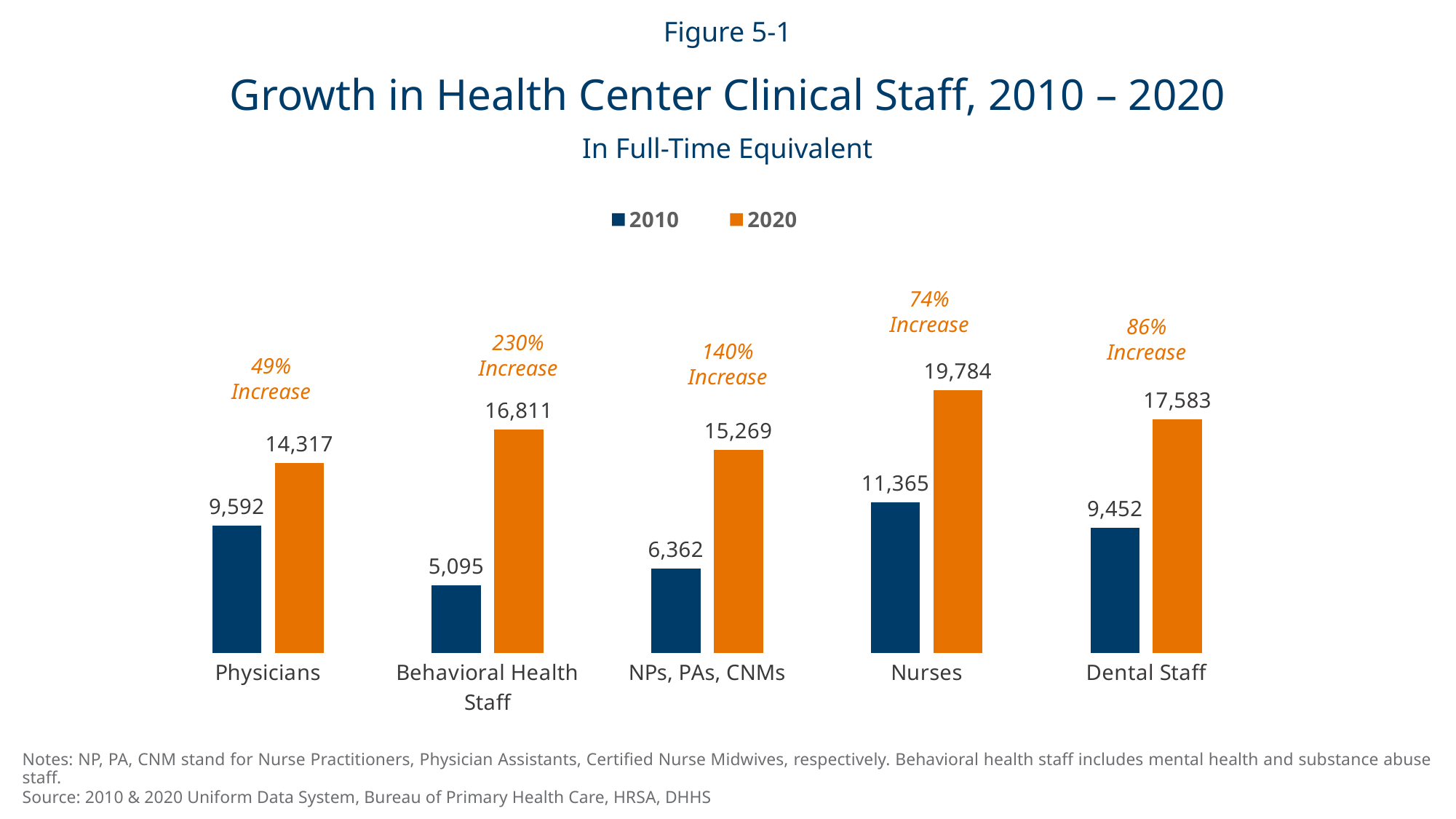
Which category had the highest value in 2020? Nurses What is the difference between the 2020 and 2010 values for Dental Staff? 8,131 How many series does the legend list? 2 How many staff categories are shown on the x axis? 5 Which colour represents the 2020 series? Orange Which category had the lowest value in 2010? Behavioral Health Staff What was the number of Nurses in 2020? 19,784 What percentage increase is shown for Behavioral Health Staff? 230% Increase What was the number of Physicians in 2010? 9,592 What was the number of Behavioral Health Staff in 2020? 16,811 What kind of chart is shown? Bar chart Which is larger: the 2010 value for Nurses or the 2010 value for Physicians? Nurses